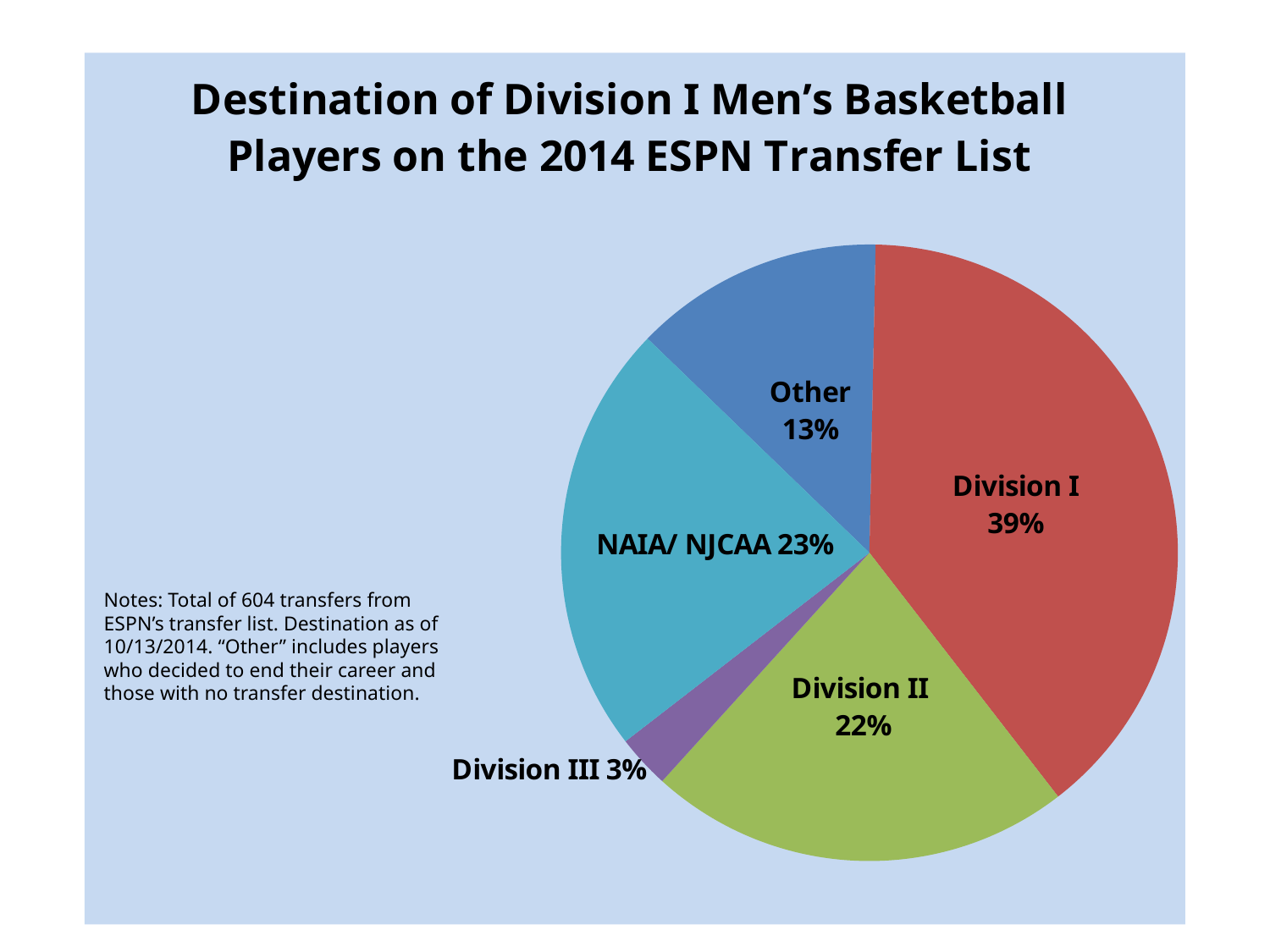
What is the title of the chart? Destination of Division I Men's Basketball Players on the 2014 ESPN Transfer List What is the difference in percentage points between Division I and Division II? 17 What percentage of transfers went to Division II? 22% What percentage is shown for Division III? 3% What percentage is shown for Other? 13% Which destination has the smallest slice of the pie? Division III Which destination has the largest slice of the pie? Division I What percentage of transfers went to NAIA/ NJCAA? 23% What share of the pie does Division I represent? 39% Which is larger, the share for Other or the share for NAIA/ NJCAA? NAIA/ NJCAA What kind of chart is shown on the slide? Pie chart How many slices does the pie chart have? 5